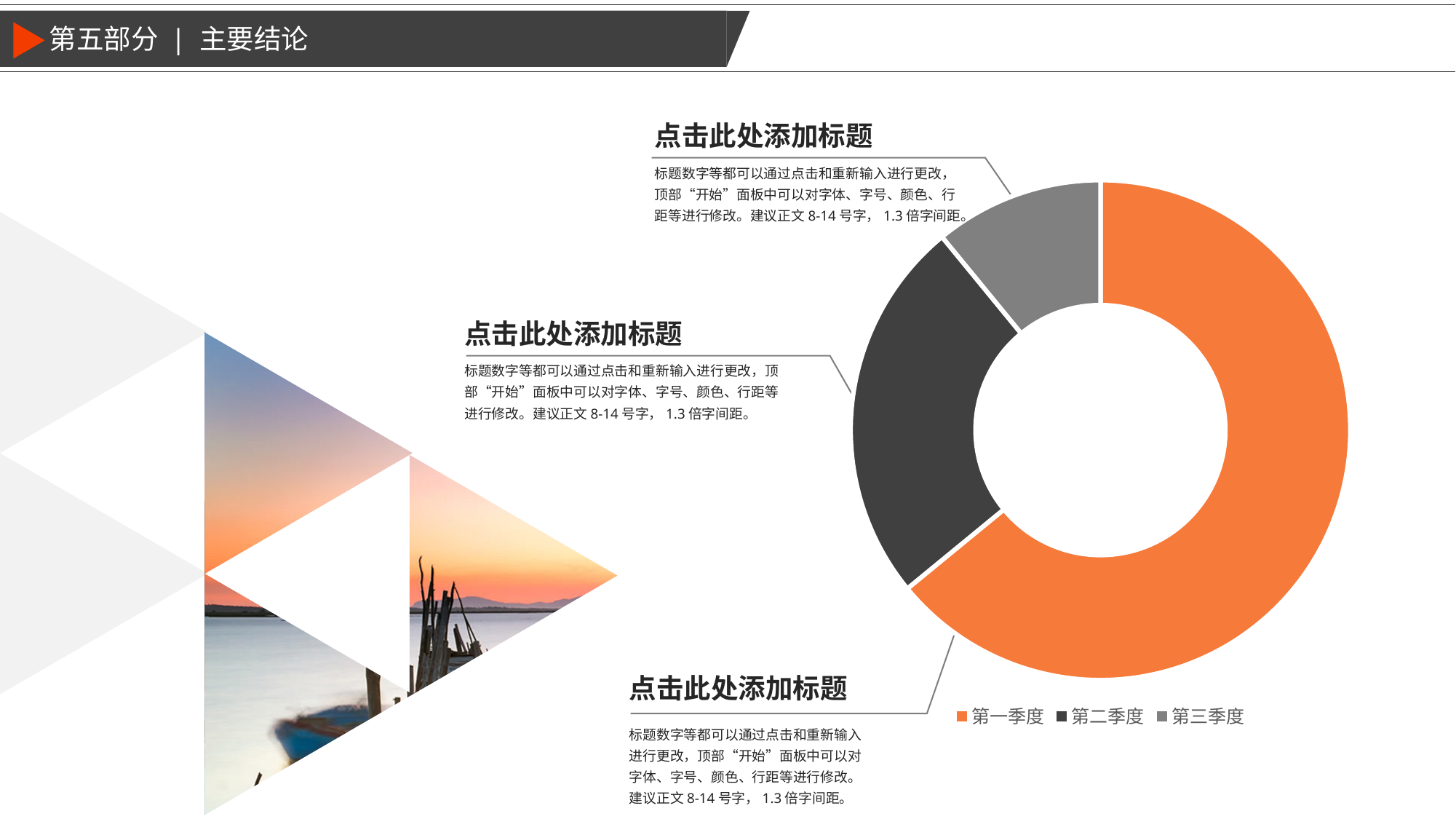
Which category has the smallest slice in the doughnut chart? 第三季度 Which slice is larger in the doughnut chart, 第一季度 or 第二季度? 第一季度 Does the 第一季度 slice take up more or less than half of the doughnut chart? more Which category is shown in dark gray in the doughnut chart? 第二季度 How many categories does the doughnut chart have? 3 What kind of chart is shown on the slide? Doughnut chart Which slice is larger in the doughnut chart, 第二季度 or 第三季度? 第二季度 What colour is the 第一季度 slice in the doughnut chart? Orange Which category has the largest slice in the doughnut chart? 第一季度 How many entries does the legend of the doughnut chart list? 3